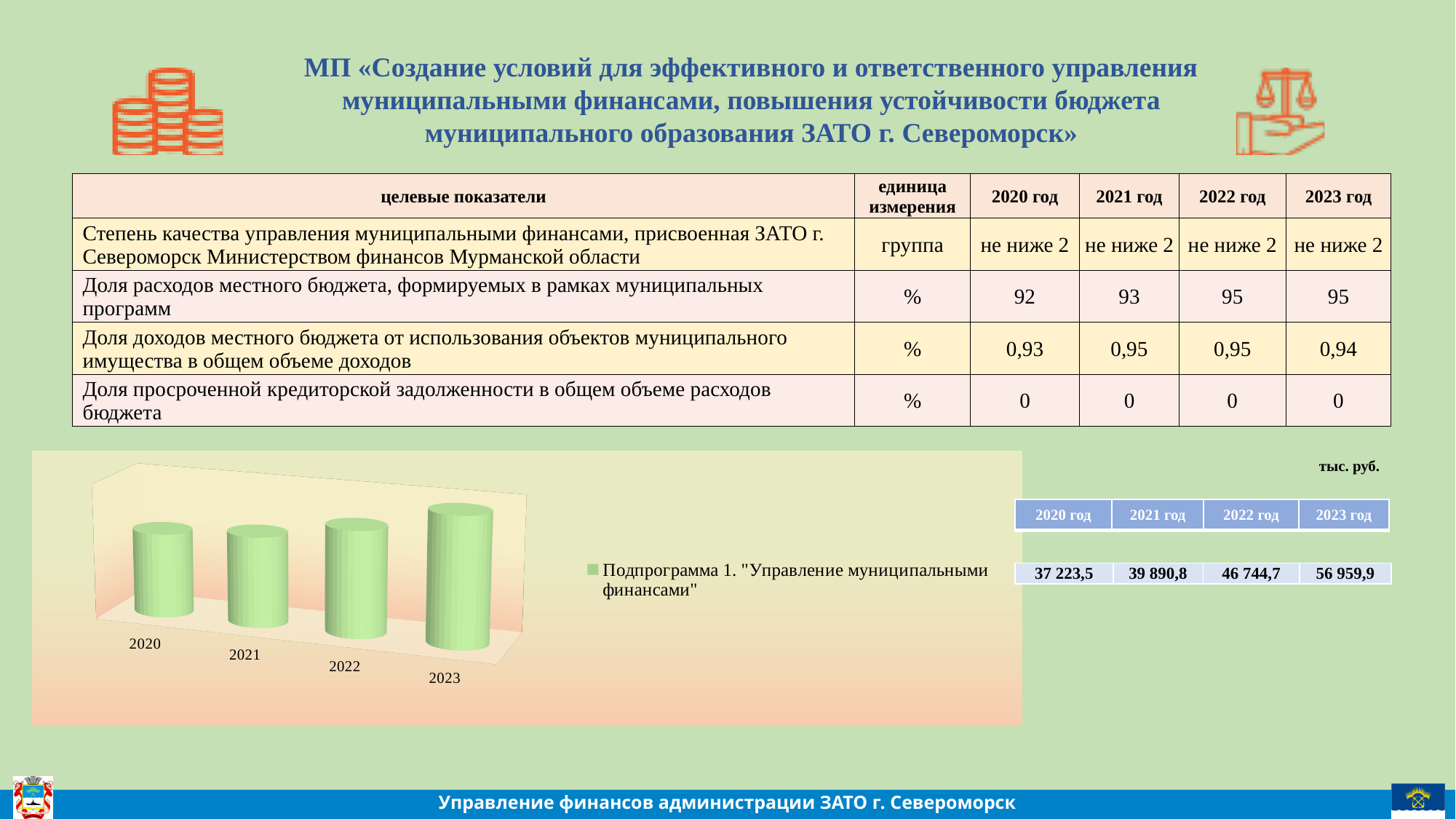
Which year has the tallest bar in the chart? 2023 Which year has the shortest bar in the chart? 2020 What is the difference between the 2023 and 2020 values shown in the table next to the chart? 19 736,4 According to the table next to the chart, what is the value for 2023 год? 56 959,9 According to the table next to the chart, what is the value for 2020 год? 37 223,5 How many series does the chart legend list? 1 In what units are the chart values given, as stated above the table next to the chart? тыс. руб. How many years (categories) are plotted in the bar chart? 4 Do the bar values rise or fall from 2020 to 2023? rise What series name is shown in the chart legend? Подпрограмма 1. "Управление муниципальными финансами" What kind of chart is shown at the bottom of the slide? bar chart Which bar is taller, 2021 or 2022? 2022